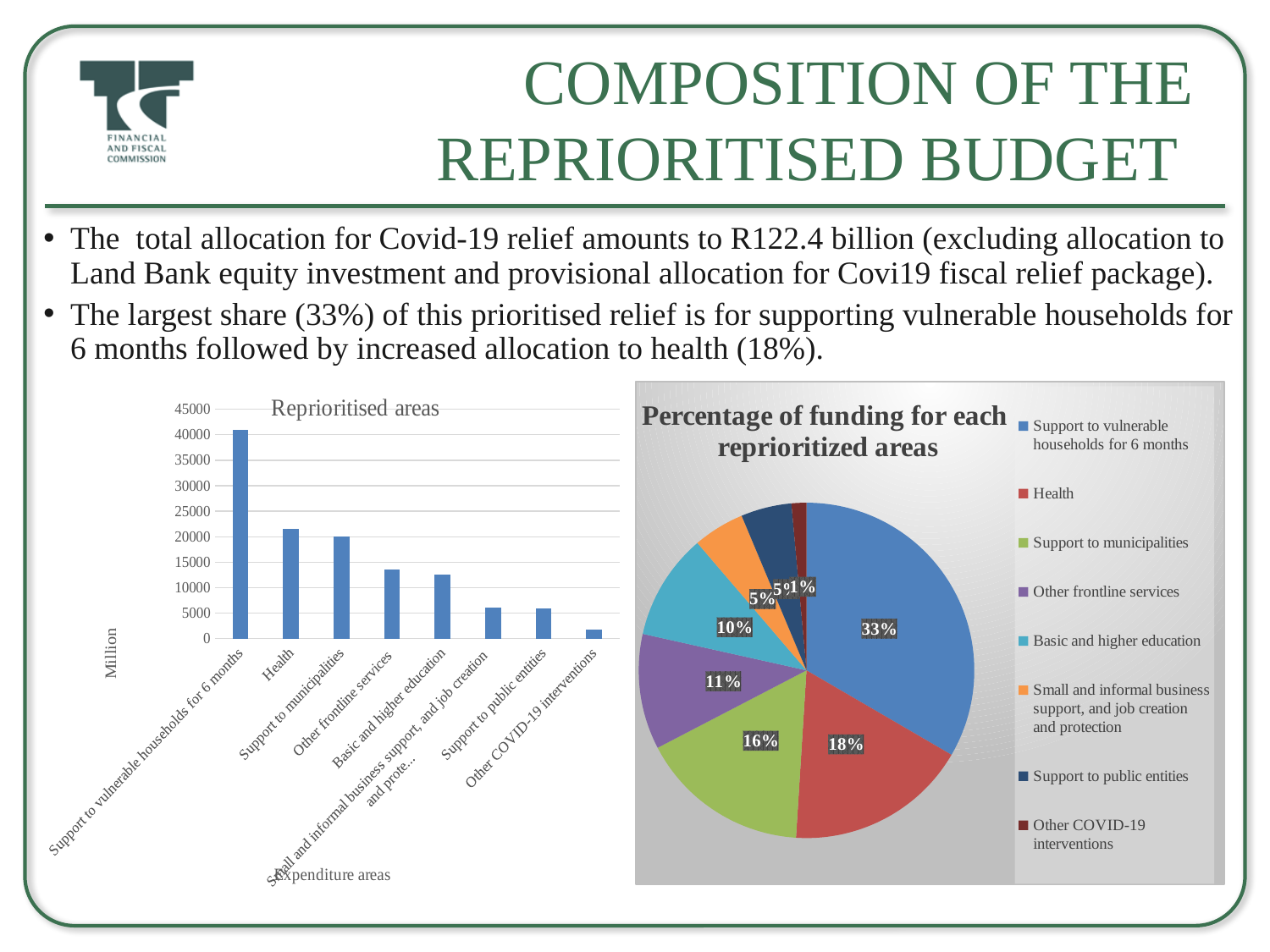
In the 'Reprioritised areas' bar chart, is the value for Support to vulnerable households for 6 months greater or less than 35000? greater In the pie chart 'Percentage of funding for each reprioritized areas', what share of funding goes to Support to municipalities? 16% What is the label on the vertical axis of the 'Reprioritised areas' bar chart? Million In the pie chart 'Percentage of funding for each reprioritized areas', how many percentage points larger is the share for Support to vulnerable households for 6 months than the share for Health? 15 percentage points How many categories does the legend of the pie chart 'Percentage of funding for each reprioritized areas' list? 8 In the 'Reprioritised areas' bar chart, is the value for Other COVID-19 interventions greater or less than 5000? less In the 'Reprioritised areas' bar chart, which expenditure area has the highest value? Support to vulnerable households for 6 months In the pie chart 'Percentage of funding for each reprioritized areas', which category has the largest slice? Support to vulnerable households for 6 months In the 'Reprioritised areas' bar chart, which is larger: the value for Support to municipalities or the value for Other frontline services? Support to municipalities In the pie chart 'Percentage of funding for each reprioritized areas', which category has the smallest slice? Other COVID-19 interventions In the pie chart 'Percentage of funding for each reprioritized areas', what share of funding goes to Health? 18% What kind of chart is the 'Reprioritised areas' chart on the left of the slide? Bar chart